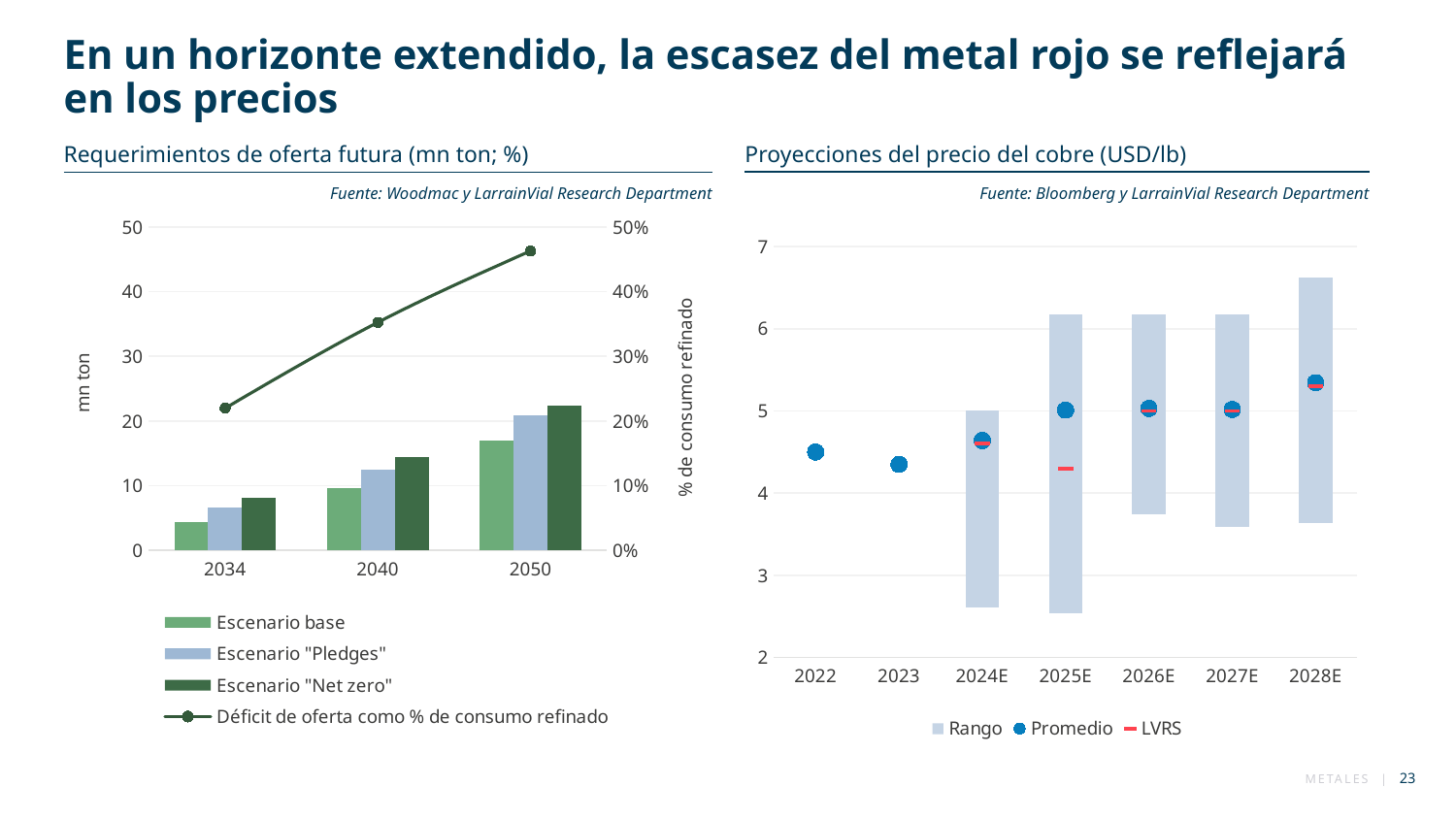
In the left chart 'Requerimientos de oferta futura', does the 'Déficit de oferta como % de consumo refinado' line rise or fall from 2034 to 2050? Rise In the left chart 'Requerimientos de oferta futura', how many entries does the legend list? 4 In the right chart 'Proyecciones del precio del cobre (USD/lb)', how many years are shown on the x axis? 7 What kind of chart is the left chart, 'Requerimientos de oferta futura (mn ton; %)'? Bar chart with a line In the left chart 'Requerimientos de oferta futura', is the 'Déficit de oferta como % de consumo refinado' value for 2050 greater or less than 40%? greater In the left chart 'Requerimientos de oferta futura', is the 'Escenario base' value for 2034 greater or less than 10 mn ton? less In the left chart 'Requerimientos de oferta futura', is the 'Escenario "Net zero"' value for 2050 greater or less than 20 mn ton? greater In the right chart 'Proyecciones del precio del cobre (USD/lb)', how many entries does the legend list? 3 In the right chart 'Proyecciones del precio del cobre (USD/lb)', which year has the highest 'Promedio' value? 2028E In the left chart 'Requerimientos de oferta futura', which scenario has the highest bar in 2050? Escenario "Net zero" In the left chart 'Requerimientos de oferta futura', how many years are shown on the x axis? 3